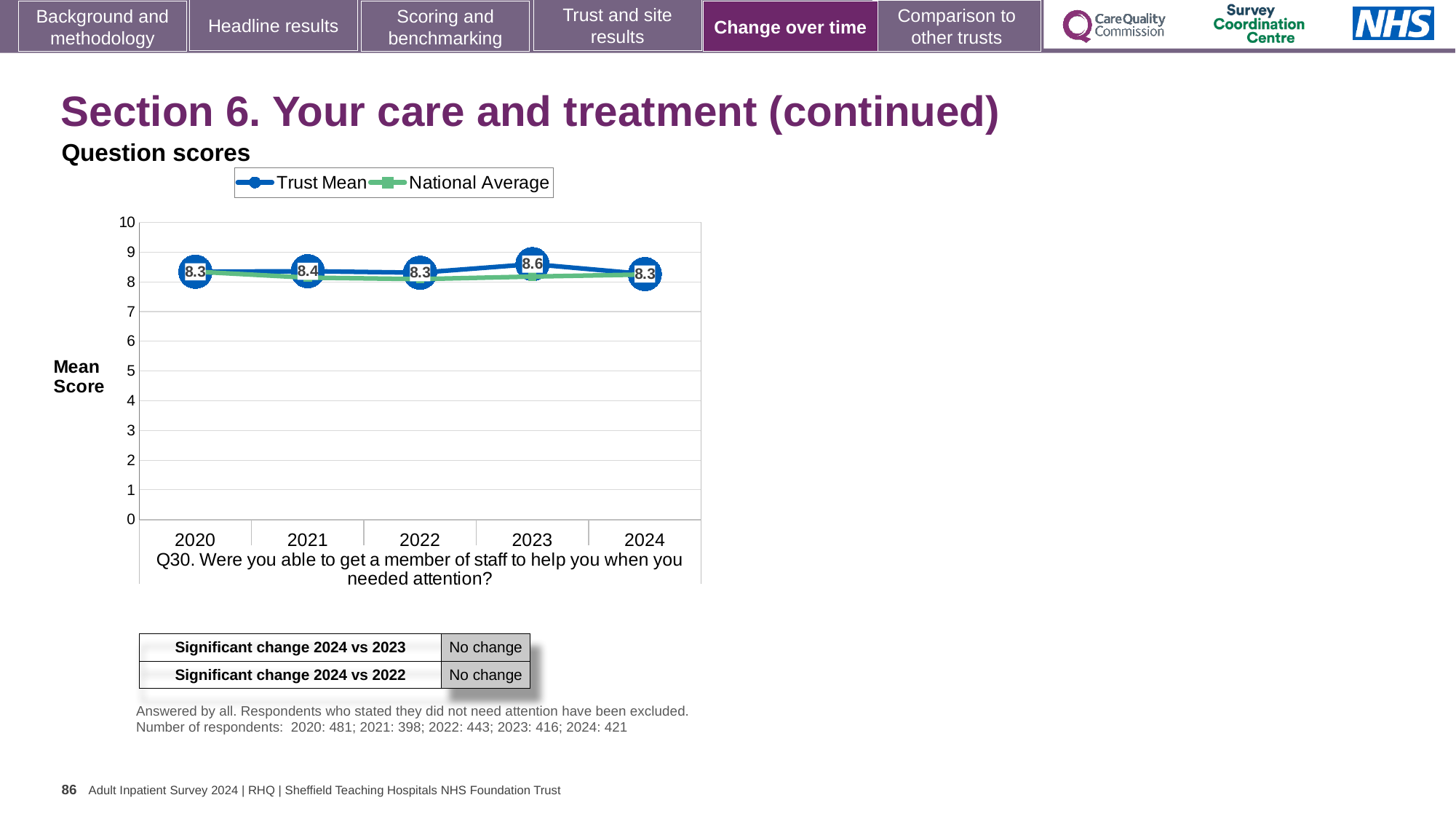
In which year is the Trust Mean score highest? 2023 How many years are plotted on the x axis? 5 How many series does the legend list? 2 What is the Trust Mean score for 2020? 8.3 Which year has the larger Trust Mean score, 2023 or 2024? 2023 What kind of chart is shown on the slide? Line chart What is the difference between the Trust Mean scores for 2023 and 2021? 0.2 Is the National Average value for 2024 greater or less than 7? greater What are the two series named in the legend? Trust Mean and National Average What is the Trust Mean score for 2023? 8.6 What is the Trust Mean score for 2021? 8.4 Did the Trust Mean score rise or fall from 2023 to 2024? Fall